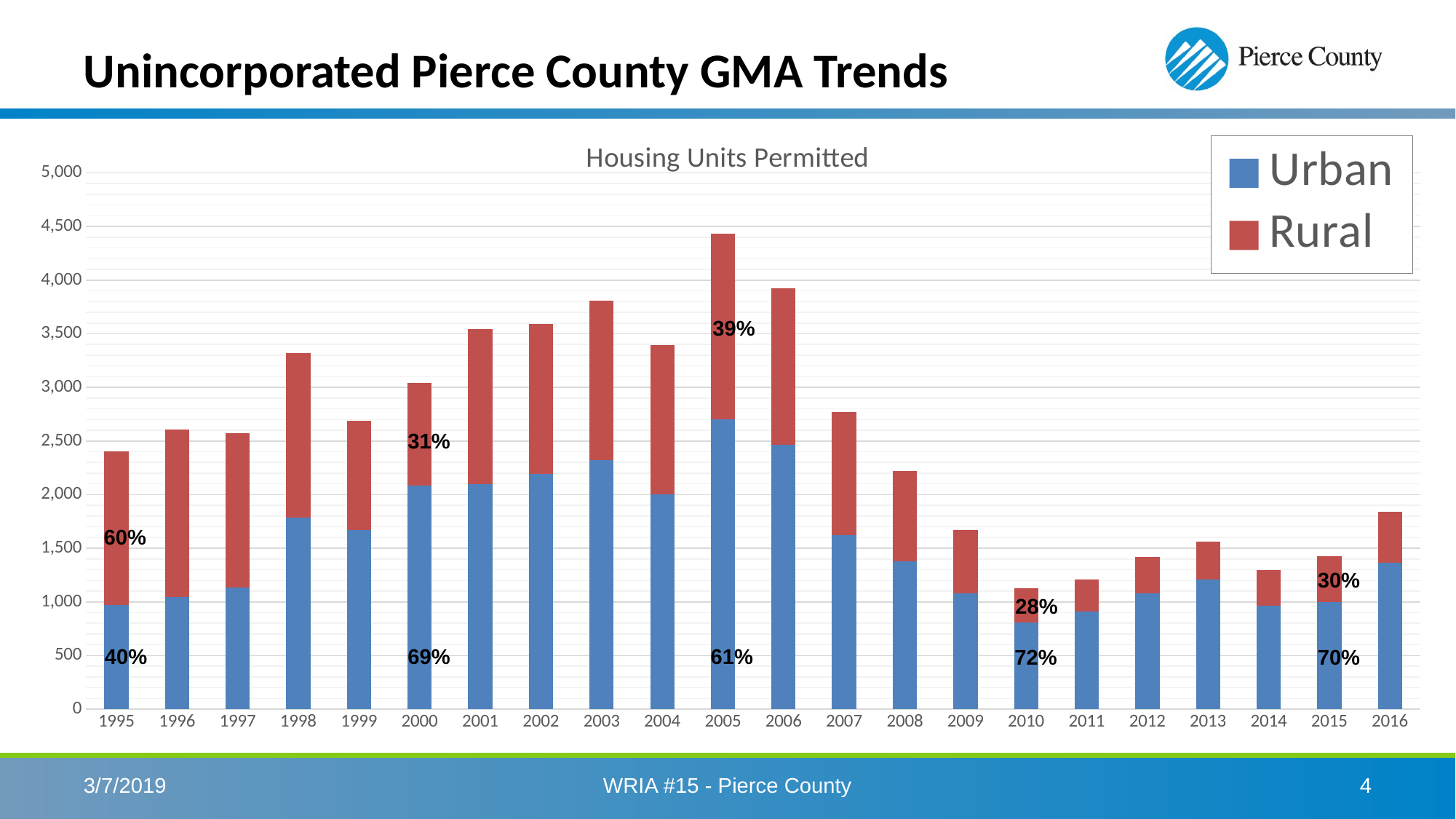
Is the total housing units permitted in 2010 greater or less than 1,500? less How many years are shown on the x axis of the chart? 22 What percentage label is shown for the Urban portion of the 2010 bar? 72% Is the total housing units permitted in 2005 greater or less than 4,000? greater What is the title of the chart? Housing Units Permitted Do total housing units permitted rise or fall from 2006 to 2010? fall What type of chart is shown on the slide? Stacked bar chart What percentage label is shown for the Urban portion of the 2015 bar? 70% Which year has the highest total housing units permitted? 2005 What percentage label is shown for the Rural portion of the 1995 bar? 60% What percentage label is shown for the Rural portion of the 2005 bar? 39% How many series does the legend list? 2